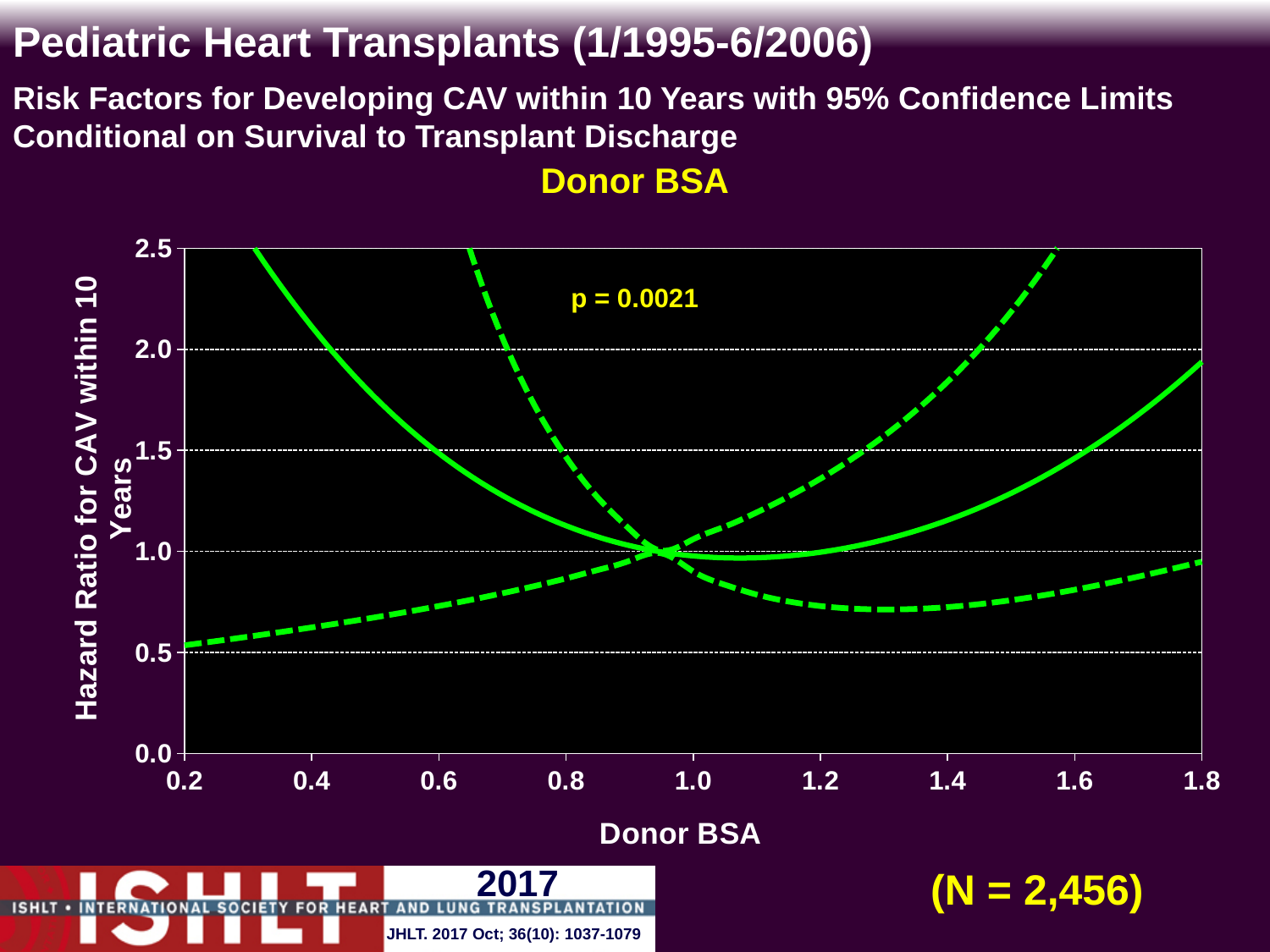
What is the title of the chart? Donor BSA Does the solid line rise or fall as Donor BSA increases from 1.2 to 1.8? rise Is the value of the solid line at Donor BSA 1.8 greater or less than 2.0? less Is the value of the solid line at Donor BSA 0.8 greater or less than 1.0? greater How many lines are plotted on the chart? 3 What p value is printed on the chart? p = 0.0021 What kind of chart is shown on the slide? line chart Does the solid line rise or fall as Donor BSA increases from 0.2 to 0.8? fall What is the label of the y axis? Hazard Ratio for CAV within 10 Years Is the value of the lower dashed line at Donor BSA 1.4 greater or less than 1.0? less What sample size (N) is printed on the slide? N = 2,456